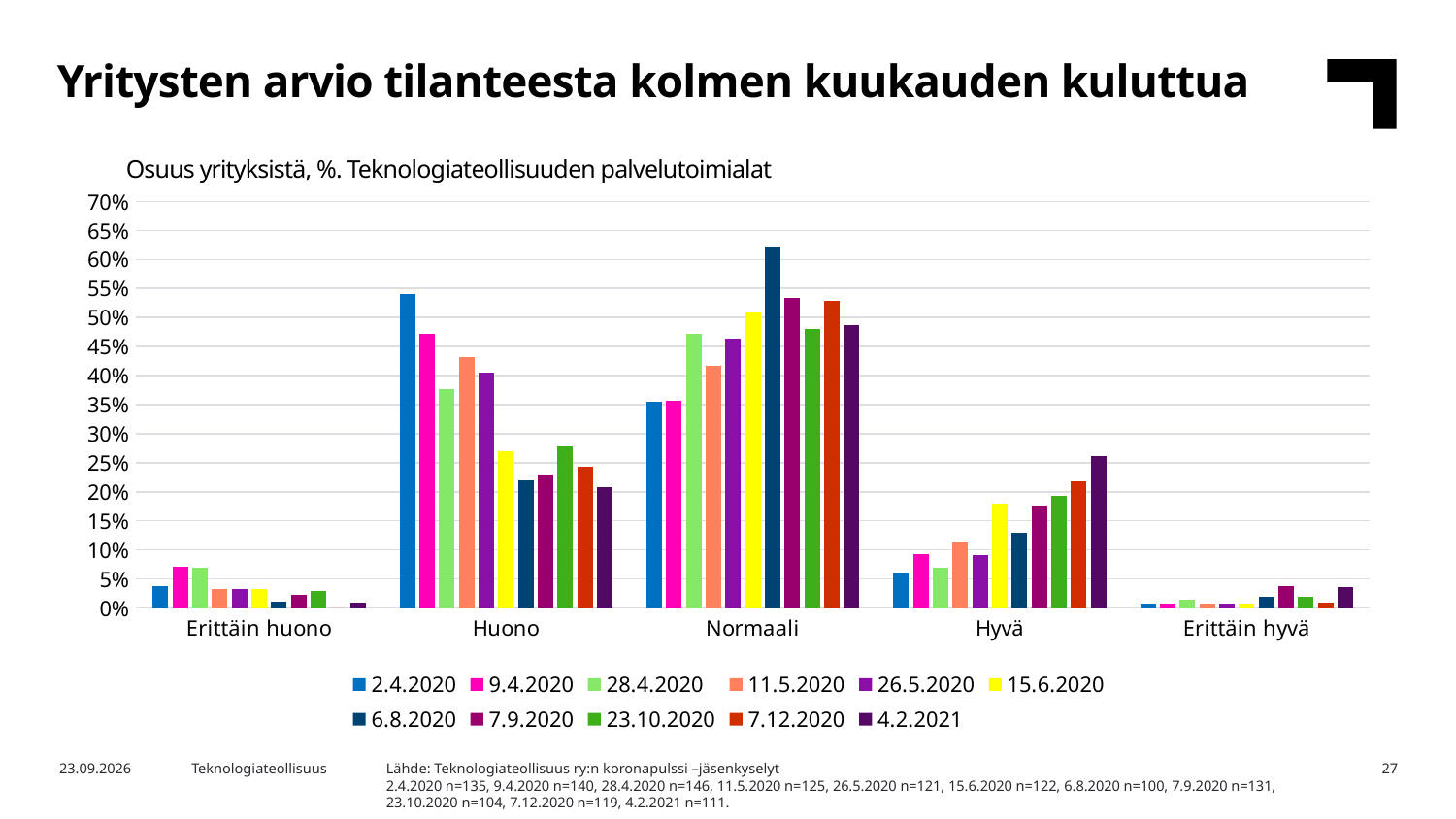
What is the subtitle shown above the chart? Osuus yrityksistä, %. Teknologiateollisuuden palvelutoimialat Is the value for 15.6.2020 in the Huono category greater or less than 30%? less Is the value for 6.8.2020 in the Normaali category greater or less than 60%? greater How many categories are shown on the x axis? 5 For the 2.4.2020 series, which is larger: the value for Huono or the value for Normaali? Huono Which series has the highest value in the Huono category? 2.4.2020 What kind of chart is shown on the slide? bar chart Is the value for 4.2.2021 in the Hyvä category greater or less than 20%? greater Which series has the highest value in the Hyvä category? 4.2.2021 How many series does the legend list? 11 Which series has the highest value in the Normaali category? 6.8.2020